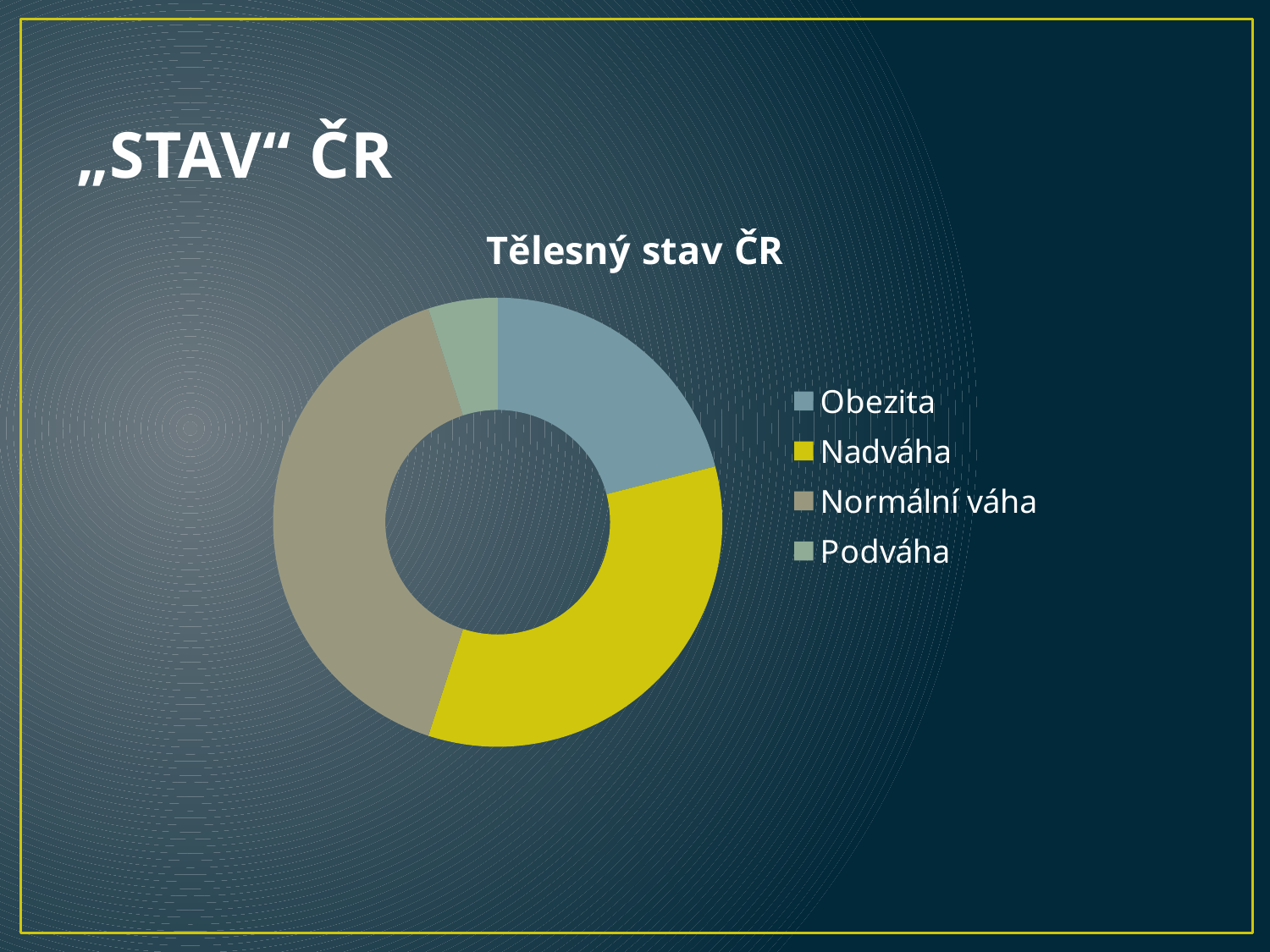
How many categories does the chart show? 4 Which slice is larger, Obezita or Podváha? Obezita Which slice is larger, Normální váha or Podváha? Normální váha What kind of chart is shown on the slide? Doughnut chart Which slice is larger, Obezita or Nadváha? Nadváha What colour is the Nadváha slice? Yellow What is the title of the chart? Tělesný stav ČR Which category has the smallest slice? Podváha How many entries does the legend list? 4